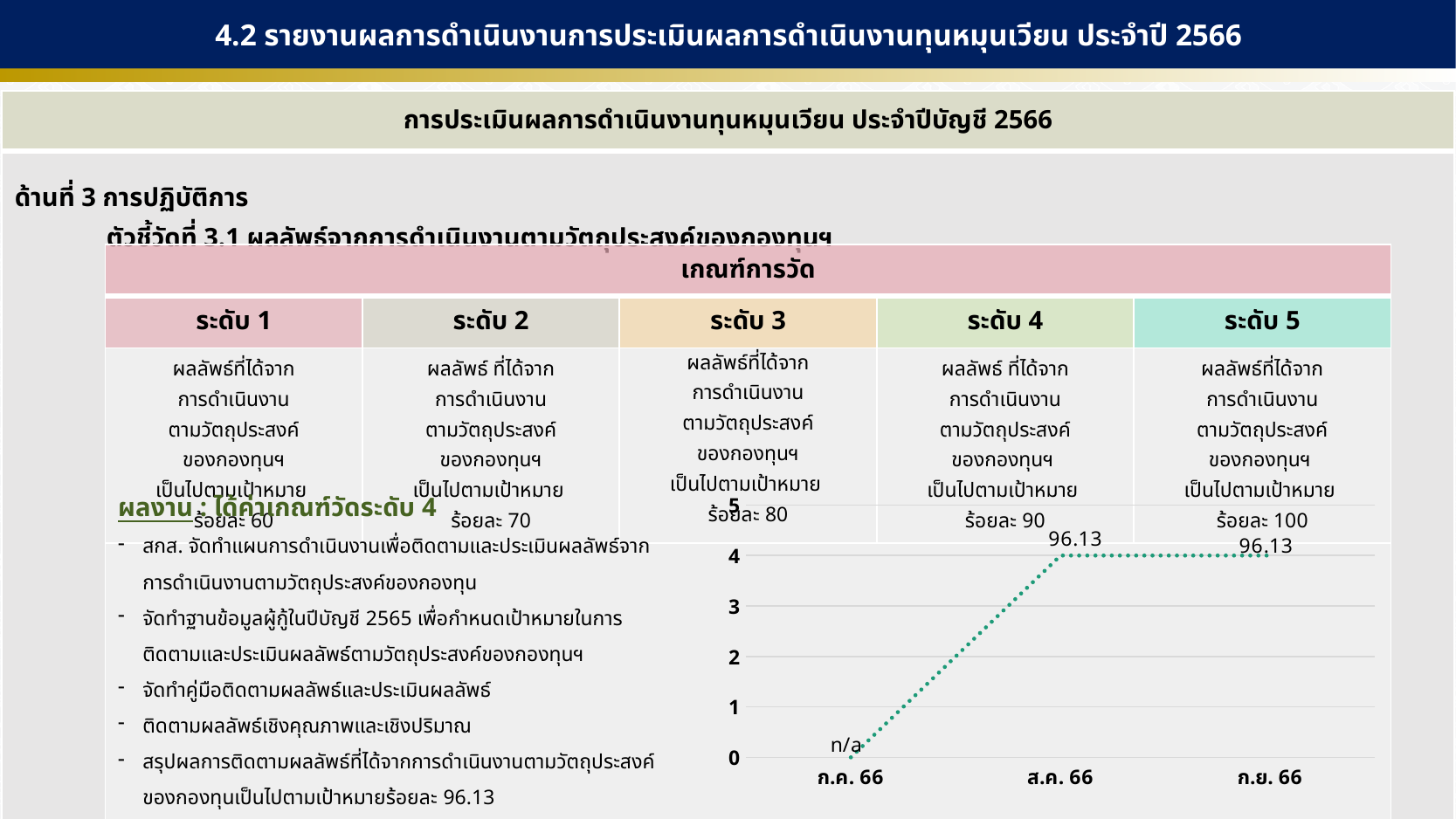
What data label is shown for ก.ค. 66 in the chart? n/a Which axis tick does the plotted point for ก.ค. 66 land on? 0 Is the plotted point for ส.ค. 66 higher or lower than the point for ก.ค. 66? higher Which month has the lowest plotted point in the chart? ก.ค. 66 What data label is shown for ส.ค. 66 in the chart? 96.13 What is the highest value shown on the y axis of the chart? 5 Which axis tick does the plotted point for ส.ค. 66 land on? 4 How many points (months) are plotted along the x axis of the chart? 3 Does the line rise or fall from ก.ค. 66 to ส.ค. 66? rise Is the plotted point for ก.ย. 66 greater or less than 3? greater What data label is shown for ก.ย. 66 in the chart? 96.13 What kind of chart is shown on the slide? line chart